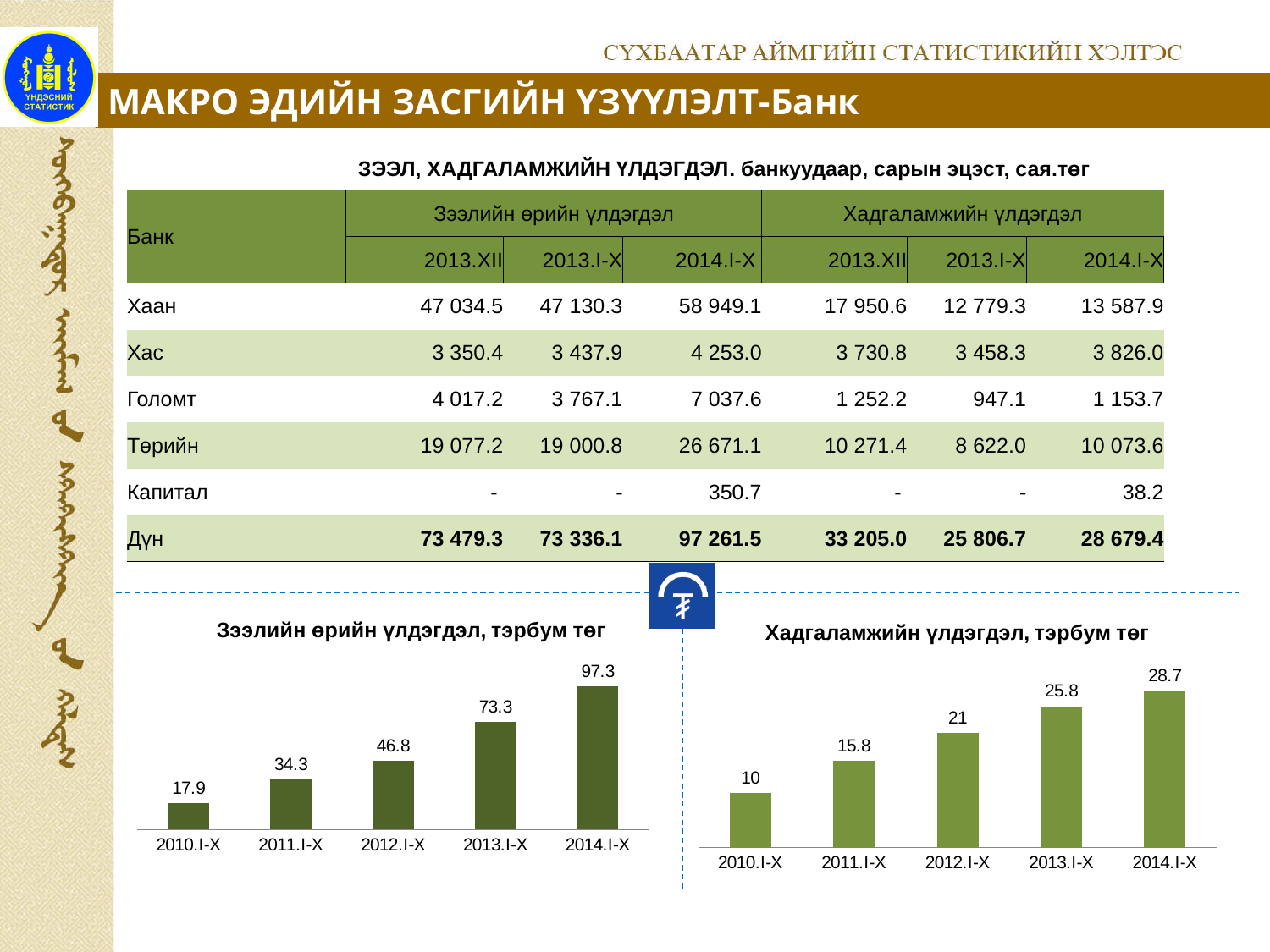
What kind of chart is the chart titled "Зээлийн өрийн үлдэгдэл, тэрбум төг"? Bar chart In the chart titled "Зээлийн өрийн үлдэгдэл, тэрбум төг", which is larger, the value for 2012.I-X or 2011.I-X? 2012.I-X In the chart titled "Зээлийн өрийн үлдэгдэл, тэрбум төг", what is the value for 2014.I-X? 97.3 In the chart titled "Хадгаламжийн үлдэгдэл, тэрбум төг", what is the difference between the values for 2011.I-X and 2010.I-X? 5.8 How many bars are shown in the chart titled "Хадгаламжийн үлдэгдэл, тэрбум төг"? 5 In the chart titled "Зээлийн өрийн үлдэгдэл, тэрбум төг", which period has the highest value? 2014.I-X In the chart titled "Хадгаламжийн үлдэгдэл, тэрбум төг", what is the value for 2013.I-X? 25.8 In the chart titled "Хадгаламжийн үлдэгдэл, тэрбум төг", which period has the lowest value? 2010.I-X In the chart titled "Зээлийн өрийн үлдэгдэл, тэрбум төг", what is the difference between the values for 2014.I-X and 2013.I-X? 24.0 In the chart titled "Зээлийн өрийн үлдэгдэл, тэрбум төг", what is the value for 2010.I-X? 17.9 In the chart titled "Хадгаламжийн үлдэгдэл, тэрбум төг", what is the value for 2012.I-X? 21 In the chart titled "Хадгаламжийн үлдэгдэл, тэрбум төг", do the values rise or fall from 2010.I-X to 2014.I-X? Rise